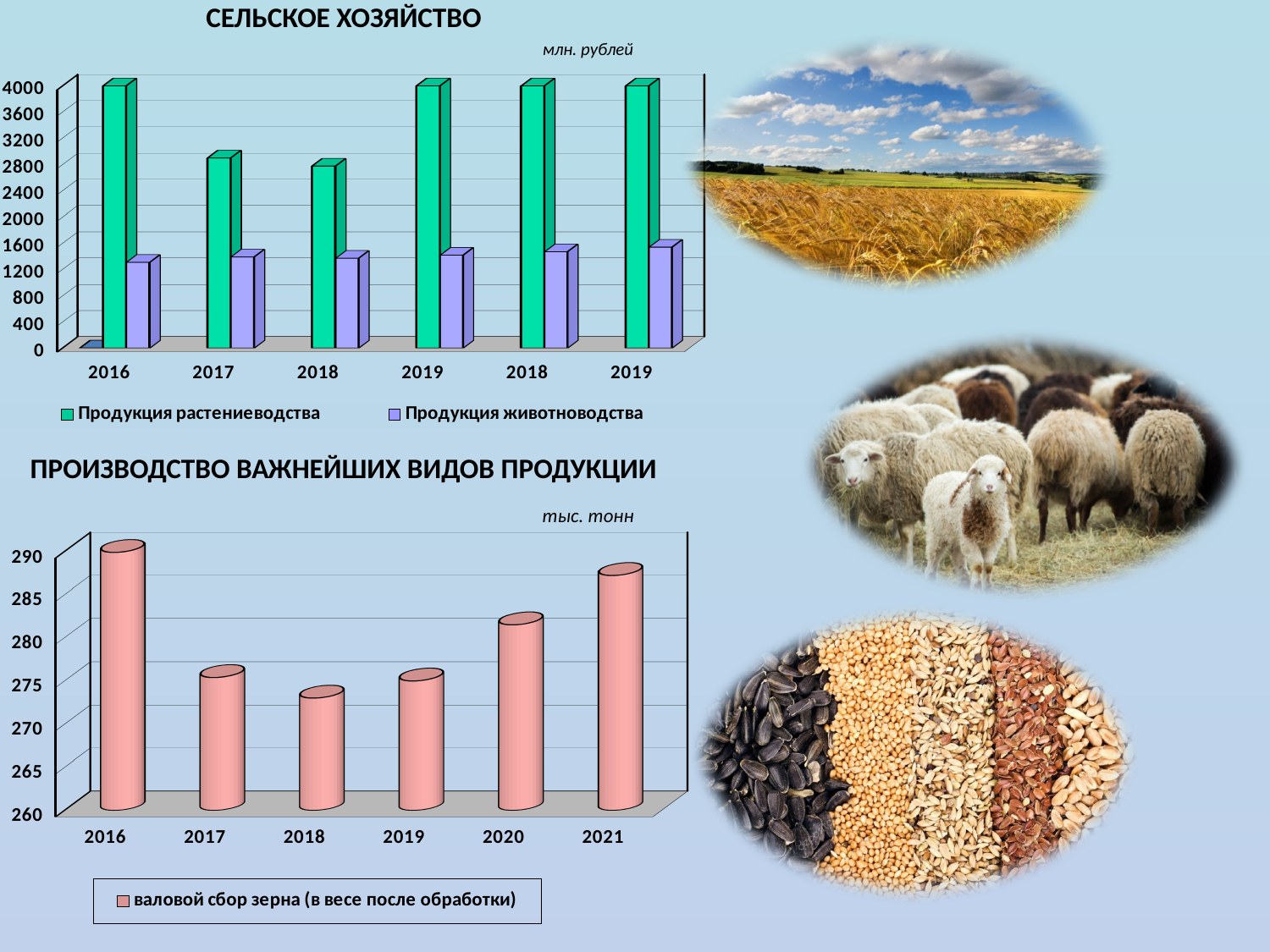
How many categories are shown on the x axis of the bottom chart 'ПРОИЗВОДСТВО ВАЖНЕЙШИХ ВИДОВ ПРОДУКЦИИ'? 6 In the bottom chart 'ПРОИЗВОДСТВО ВАЖНЕЙШИХ ВИДОВ ПРОДУКЦИИ', which year has the larger value: 2020 or 2021? 2021 In the top chart 'СЕЛЬСКОЕ ХОЗЯЙСТВО', which series has the larger value in 2017: 'Продукция растениеводства' or 'Продукция животноводства'? Продукция растениеводства How many series does the legend of the top chart 'СЕЛЬСКОЕ ХОЗЯЙСТВО' list? 2 What unit is shown above the top chart 'СЕЛЬСКОЕ ХОЗЯЙСТВО'? млн. рублей In the bottom chart 'ПРОИЗВОДСТВО ВАЖНЕЙШИХ ВИДОВ ПРОДУКЦИИ', is the value for 2020 greater or less than 280? greater In the bottom chart 'ПРОИЗВОДСТВО ВАЖНЕЙШИХ ВИДОВ ПРОДУКЦИИ', do the values rise or fall from 2018 to 2021? rise In the top chart 'СЕЛЬСКОЕ ХОЗЯЙСТВО', is the value for 'Продукция животноводства' in 2016 greater or less than 2000? less In the bottom chart 'ПРОИЗВОДСТВО ВАЖНЕЙШИХ ВИДОВ ПРОДУКЦИИ', which year has the lowest value? 2018 What kind of chart is the top chart titled 'СЕЛЬСКОЕ ХОЗЯЙСТВО'? Bar chart In the bottom chart 'ПРОИЗВОДСТВО ВАЖНЕЙШИХ ВИДОВ ПРОДУКЦИИ', which year has the highest value? 2016 In the top chart 'СЕЛЬСКОЕ ХОЗЯЙСТВО', is the value for 'Продукция растениеводства' in 2017 greater or less than 2000? greater